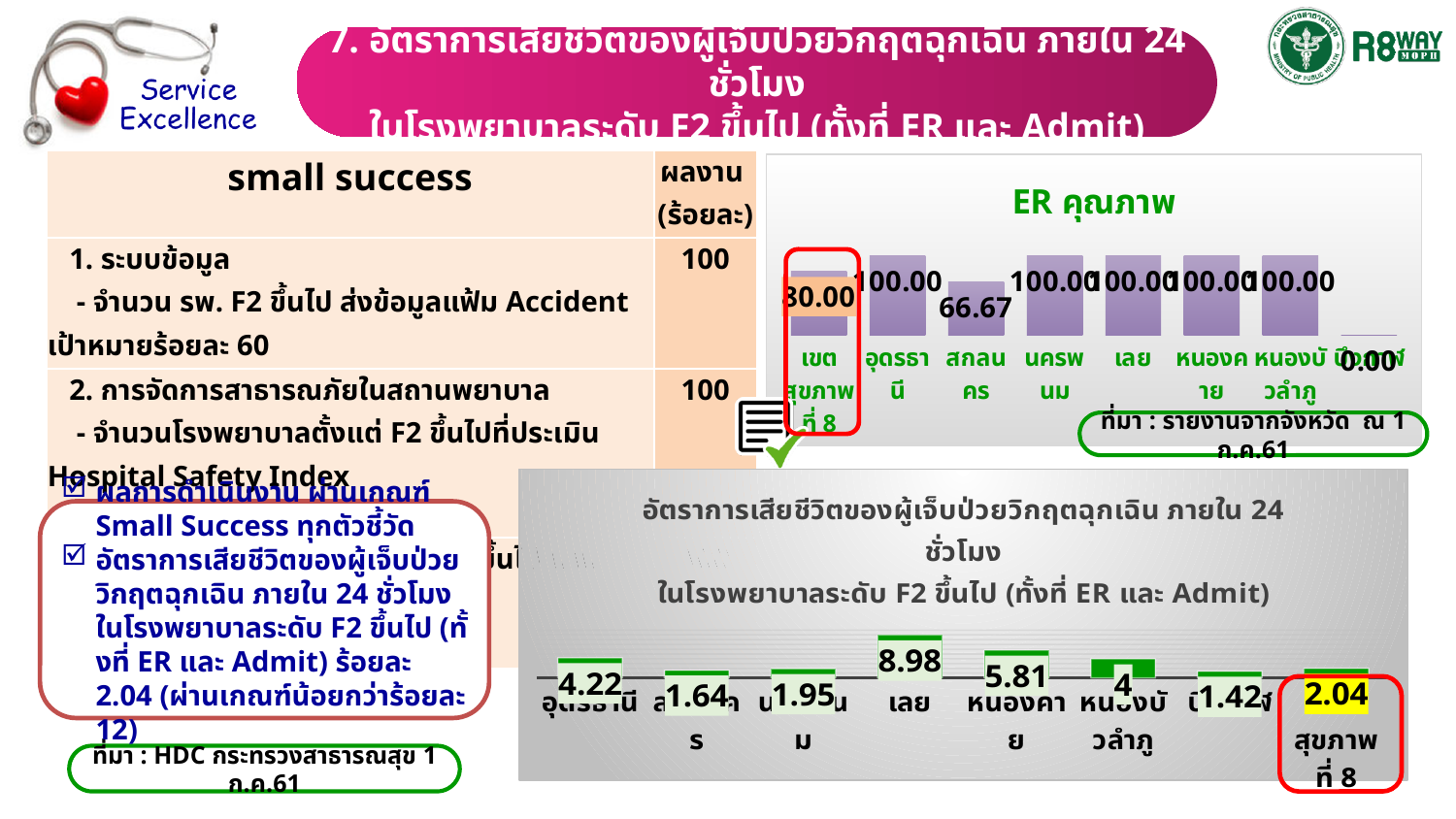
In the 'ER คุณภาพ' chart, what is the value for เขตสุขภาพที่ 8? 80.00 In the 'ER คุณภาพ' chart, what is the value for อุดรธานี? 100.00 In the 'ER คุณภาพ' chart, what kind of chart is shown? bar chart In the bottom chart on mortality rate within 24 hours, what is the value for เลย? 8.98 In the bottom chart on mortality rate within 24 hours, which province has the highest value? เลย In the bottom chart on mortality rate within 24 hours, what is the value for หนองคาย? 5.81 In the bottom chart on mortality rate within 24 hours, what is the difference between the values for เลย and อุดรธานี? 4.76 In the 'ER คุณภาพ' chart, what is the value for สกลนคร? 66.67 In the bottom chart on mortality rate within 24 hours, which of หนองคาย or หนองบัวลำภู has the larger value? หนองคาย In the bottom chart on mortality rate within 24 hours, what is the value for เขตสุขภาพที่ 8? 2.04 In the 'ER คุณภาพ' chart, which of อุดรธานี or สกลนคร has the larger value? อุดรธานี In the 'ER คุณภาพ' chart, what is the difference between the values for นครพนม and สกลนคร? 33.33